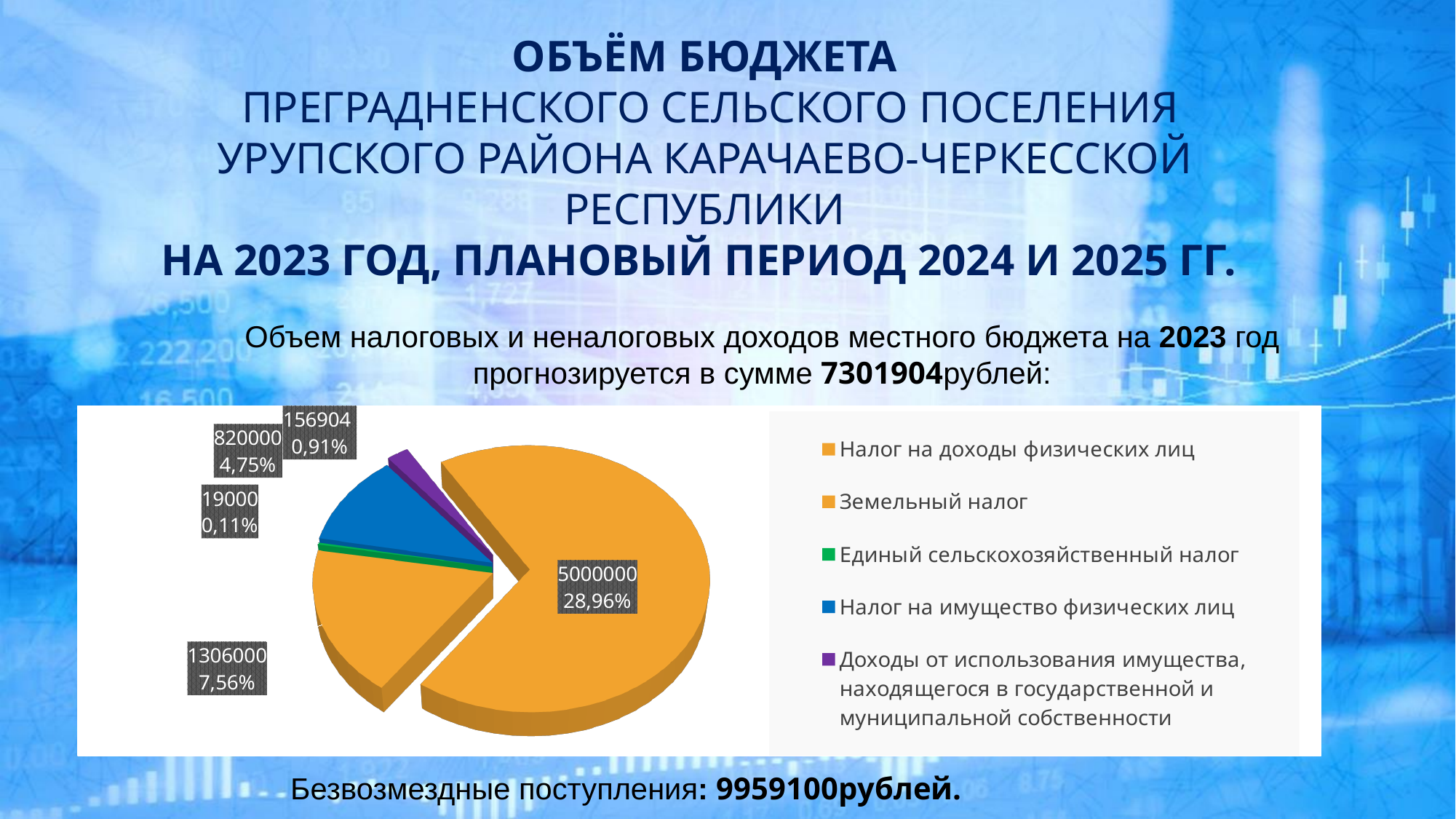
What percentage is shown for the slice with value 5000000? 28,96% How many entries does the legend of the pie chart list? 5 What value is shown for the slice labelled 0,11%? 19000 What is the difference between the slice valued 5000000 and the slice valued 1306000? 3694000 Which legend entry is shown with a green marker? Единый сельскохозяйственный налог What value is shown for the largest slice of the pie chart? 5000000 What value is shown for the slice labelled 4,75%? 820000 What kind of chart is shown on the slide? Pie chart How many slices does the pie chart have? 5 What value is shown for the slice labelled 0,91%? 156904 What percentage is shown for the slice with value 1306000? 7,56% Which slice of the pie chart has the smallest value? Единый сельскохозяйственный налог (19000, 0,11%)